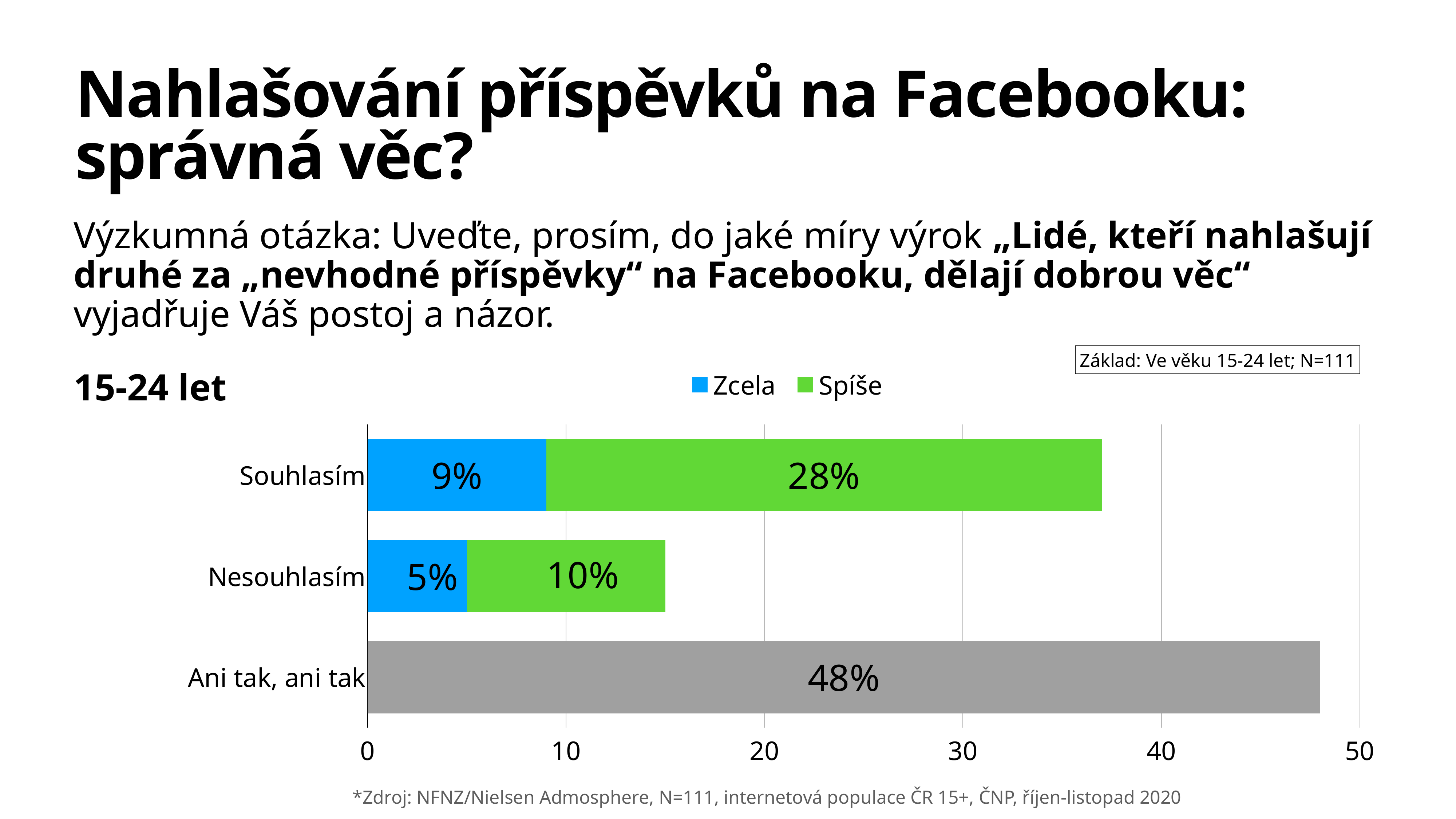
What is the 'Spíše' value for Nesouhlasím? 10% What is the 'Zcela' value for Souhlasím? 9% What is the 'Zcela' value for Nesouhlasím? 5% What is the total of the stacked bar for Nesouhlasím? 15% What is the total of the stacked bar for Souhlasím? 37% What is the 'Spíše' value for Souhlasím? 28% What kind of chart is shown on the slide? bar chart What is the difference between the 'Spíše' values for Souhlasím and Nesouhlasím? 18% How many categories are shown on the y axis of the chart? 3 What is the value for 'Ani tak, ani tak'? 48% Which is larger: the 'Zcela' value for Souhlasím or the 'Zcela' value for Nesouhlasím? Souhlasím How many series does the legend list? 2